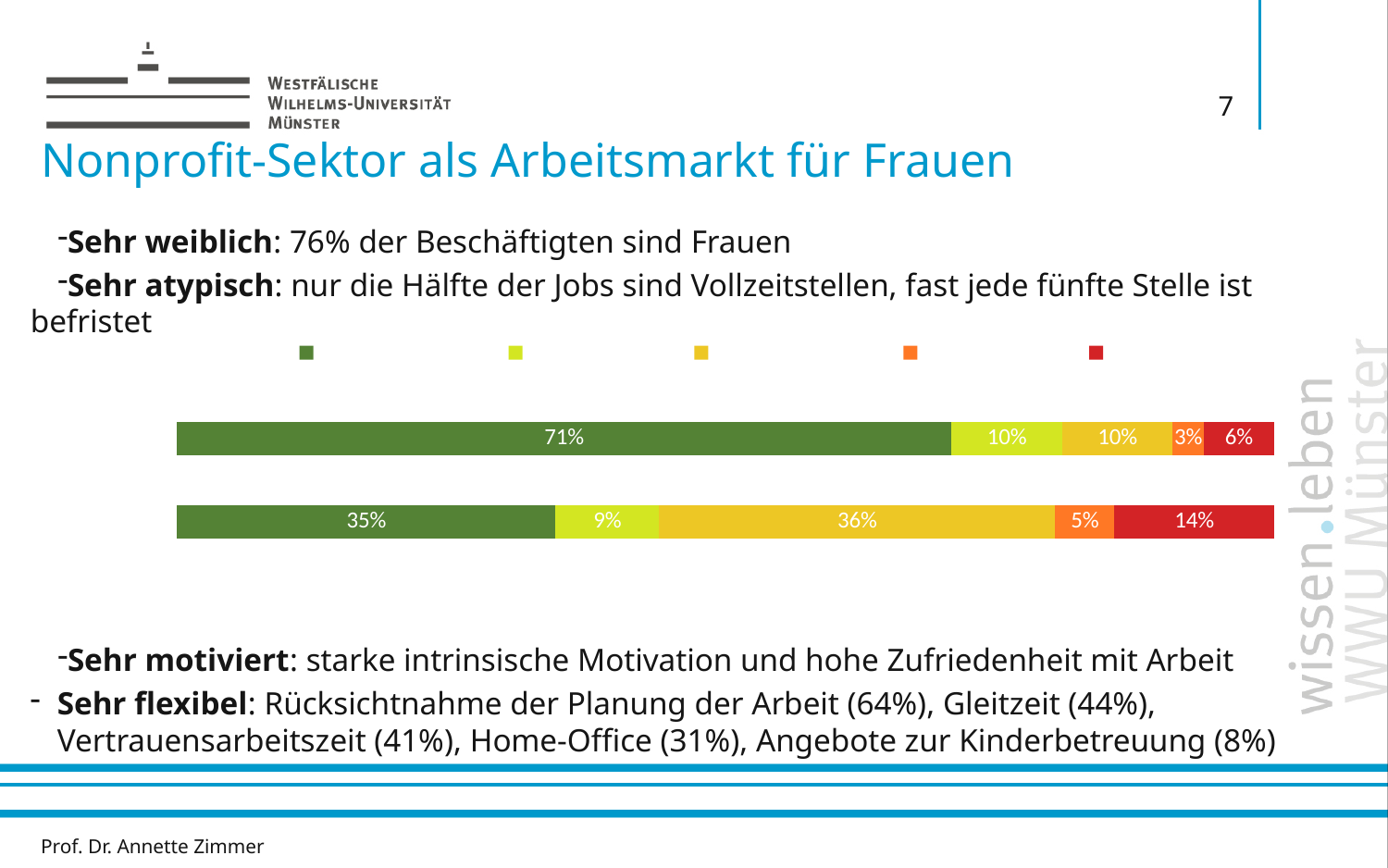
How many bars does the chart contain? 2 What is the value of the red segment in the top bar? 6% What is the difference between the dark green segment of the top bar and the dark green segment of the bottom bar? 36 percentage points What is the value of the red segment in the bottom bar? 14% What is the value of the dark green segment in the top bar? 71% Which segment is the largest in the bottom bar? the yellow segment (36%) Is the red segment larger in the top bar or in the bottom bar? bottom bar What is the total of all segments in the top bar? 100% How many series does the legend list? 5 What is the value of the dark green segment in the bottom bar? 35% What is the value of the yellow (third) segment in the bottom bar? 36% What kind of chart is shown on the slide? bar chart